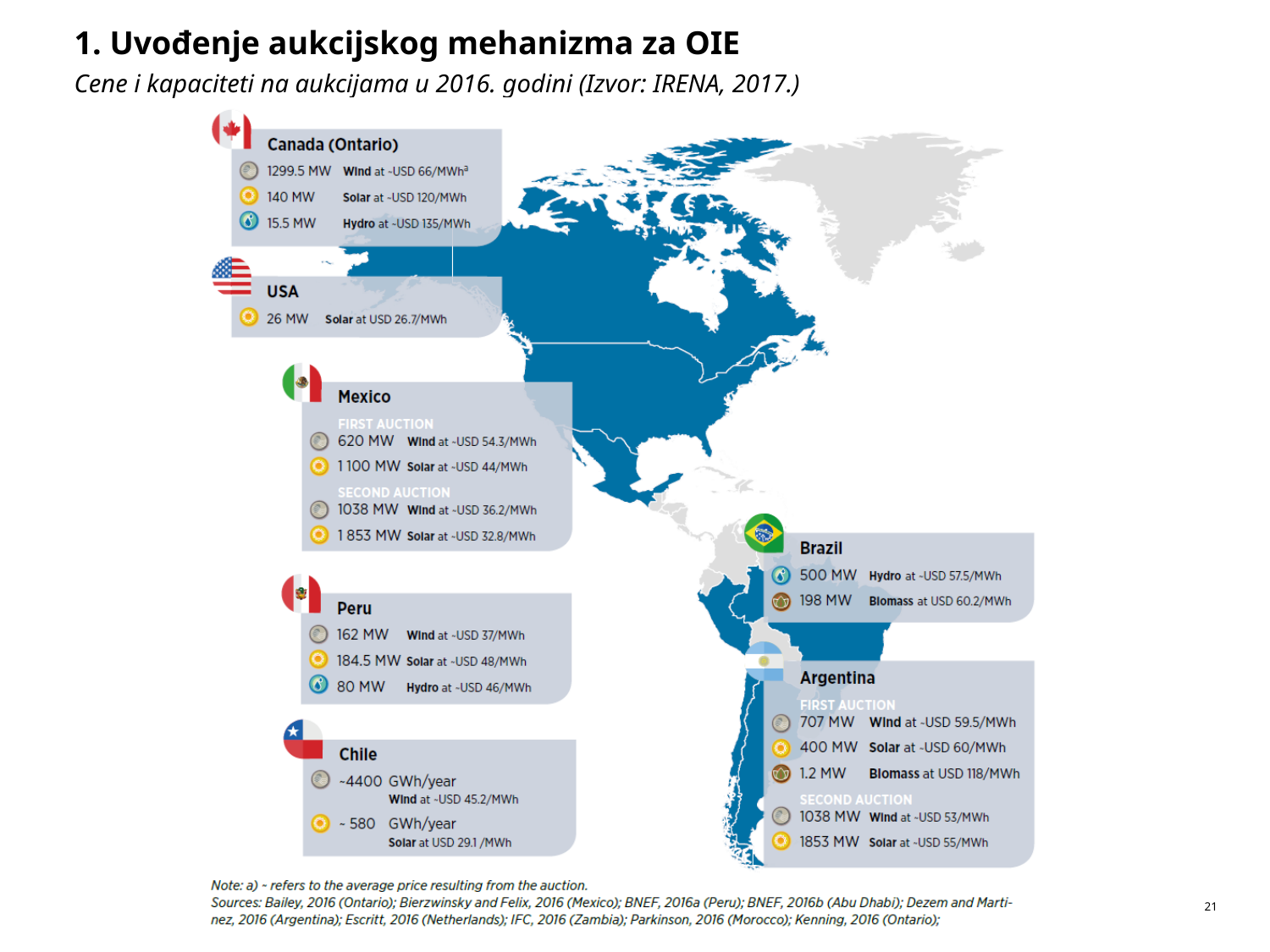
Which of Canada (Ontario)'s three technologies has the smallest listed capacity? Hydro What is the difference between Brazil's hydro capacity and its biomass capacity? 302 MW Which of Peru's three technologies has the largest listed capacity? Solar What wind capacity is listed for Canada (Ontario)? 1299.5 MW What solar capacity is listed for Mexico's second auction? 1 853 MW What biomass capacity is listed for Argentina's first auction? 1.2 MW What is the hydro price listed for Brazil? ~USD 57.5/MWh How many countries have data callouts on the map? 7 Which is larger: Mexico's first-auction wind capacity or Peru's wind capacity? Mexico's first-auction wind capacity What kind of visual is shown on the slide? A map infographic What wind output is listed for Chile? ~4400 GWh/year What is the solar price listed for the USA? USD 26.7/MWh